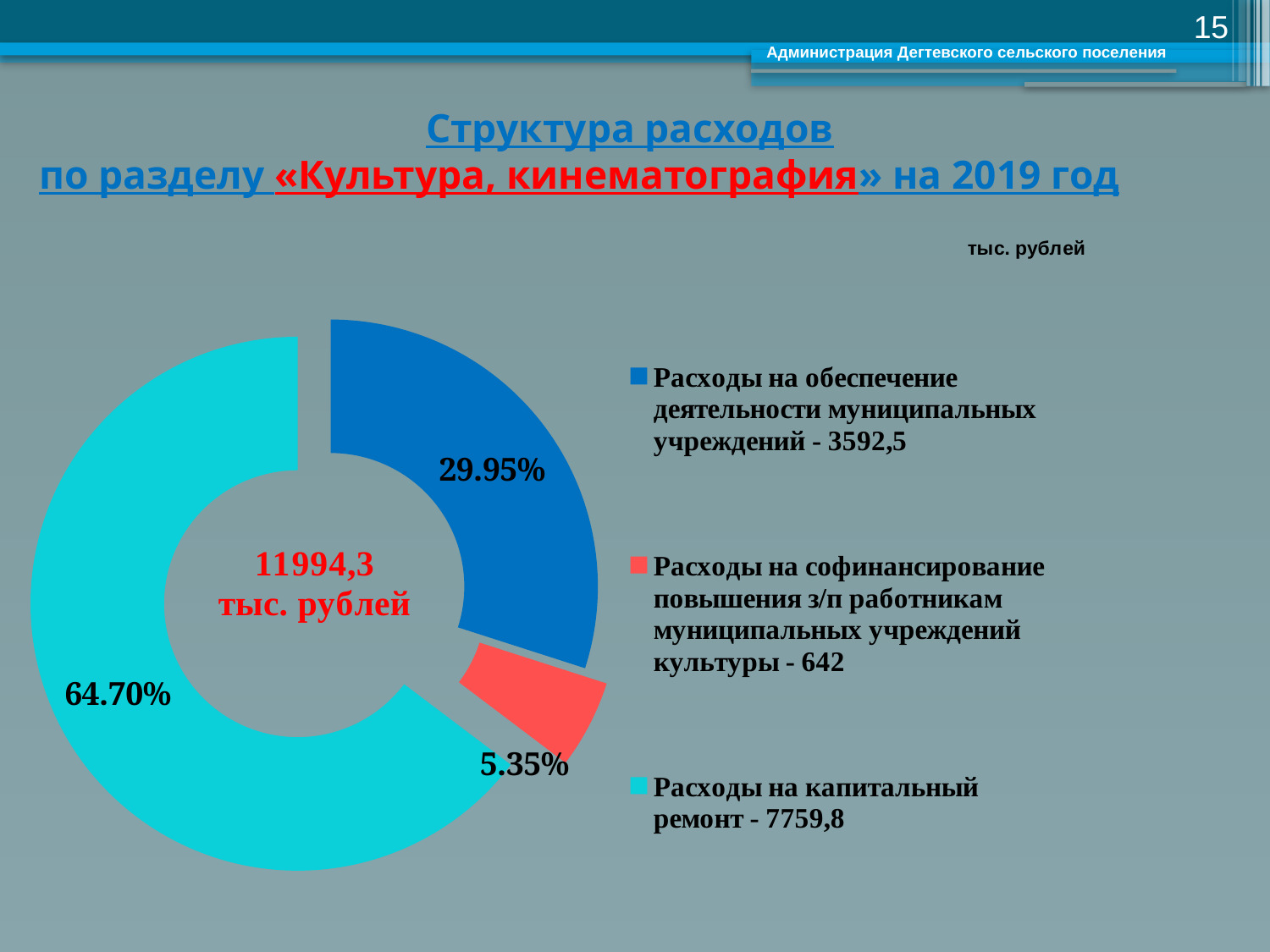
Which category has the largest share of the chart? Расходы на капитальный ремонт What is the difference in percentage points between the share for "Расходы на капитальный ремонт" and the share for "Расходы на обеспечение деятельности муниципальных учреждений"? 34.75% What share of the chart does "Расходы на обеспечение деятельности муниципальных учреждений" take? 29.95% What is the value (тыс. рублей) for "Расходы на капитальный ремонт" according to the legend? 7759,8 Which colour represents "Расходы на капитальный ремонт" in the chart? Cyan (light blue) What share of the chart does "Расходы на капитальный ремонт" take? 64.70% How many categories does the chart show? 3 What total amount is shown in the centre of the chart? 11994,3 тыс. рублей Which category has the smallest share of the chart? Расходы на софинансирование повышения з/п работникам муниципальных учреждений культуры What share of the chart does "Расходы на софинансирование повышения з/п работникам муниципальных учреждений культуры" take? 5.35% What is the value (тыс. рублей) for "Расходы на софинансирование повышения з/п работникам муниципальных учреждений культуры" according to the legend? 642 What kind of chart is shown on the slide? Doughnut (pie) chart